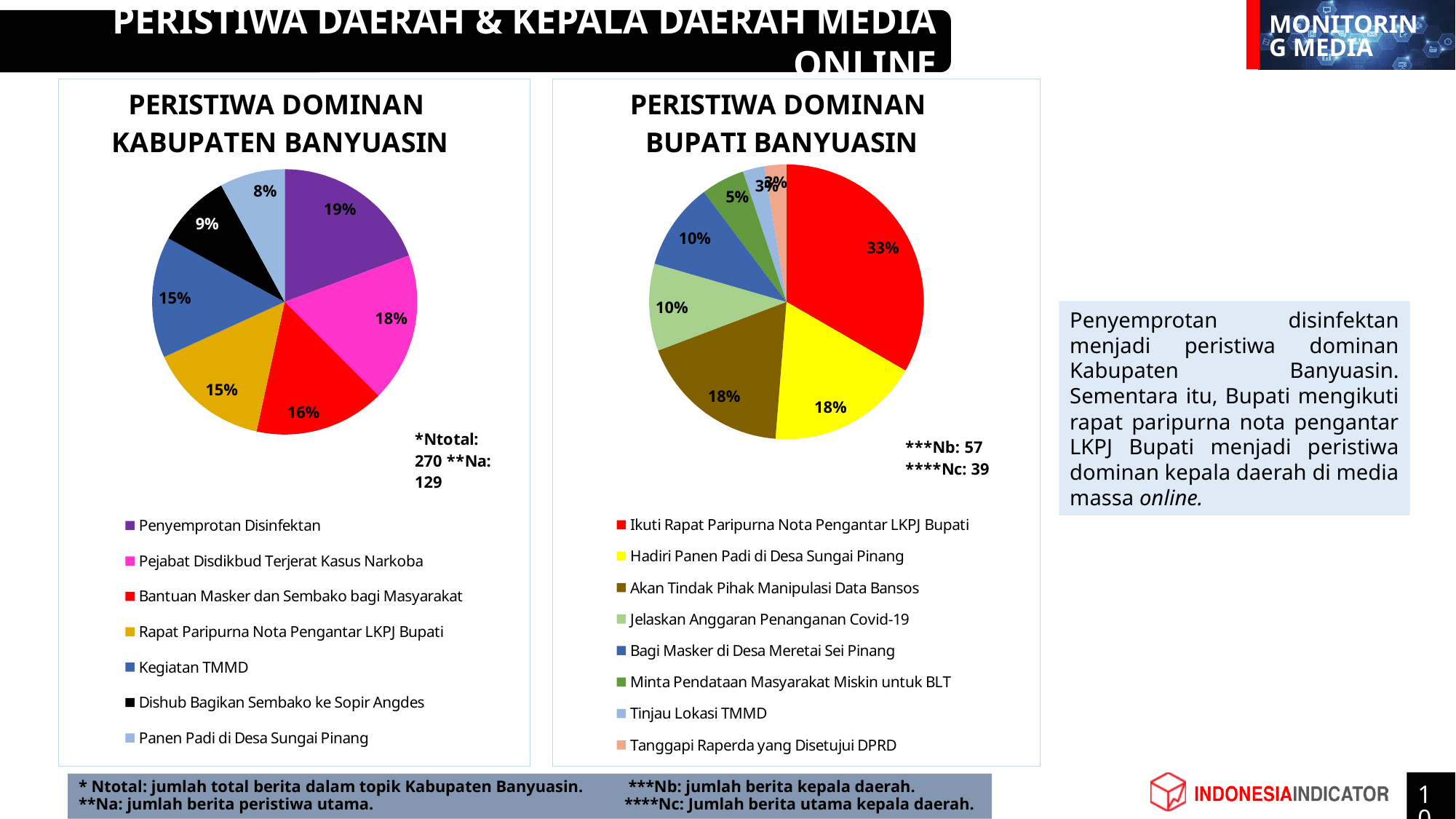
On the PERISTIWA DOMINAN BUPATI BANYUASIN chart, what share does Minta Pendataan Masyarakat Miskin untuk BLT have? 5% What type of chart is the PERISTIWA DOMINAN BUPATI BANYUASIN chart? Pie chart On the PERISTIWA DOMINAN KABUPATEN BANYUASIN chart, which category has the largest share? Penyemprotan Disinfektan On the PERISTIWA DOMINAN BUPATI BANYUASIN chart, which is larger: Hadiri Panen Padi di Desa Sungai Pinang or Jelaskan Anggaran Penanganan Covid-19? Hadiri Panen Padi di Desa Sungai Pinang On the PERISTIWA DOMINAN KABUPATEN BANYUASIN chart, what share does Bantuan Masker dan Sembako bagi Masyarakat have? 16% On the PERISTIWA DOMINAN KABUPATEN BANYUASIN chart, what share does Penyemprotan Disinfektan have? 19% On the PERISTIWA DOMINAN BUPATI BANYUASIN chart, which category has the largest share? Ikuti Rapat Paripurna Nota Pengantar LKPJ Bupati On the PERISTIWA DOMINAN BUPATI BANYUASIN chart, how many categories does the legend list? 8 On the PERISTIWA DOMINAN BUPATI BANYUASIN chart, what share does Ikuti Rapat Paripurna Nota Pengantar LKPJ Bupati have? 33% On the PERISTIWA DOMINAN KABUPATEN BANYUASIN chart, how many categories does the legend list? 7 On the PERISTIWA DOMINAN KABUPATEN BANYUASIN chart, what is the difference between the shares of Pejabat Disdikbud Terjerat Kasus Narkoba and Dishub Bagikan Sembako ke Sopir Angdes? 9% On the PERISTIWA DOMINAN KABUPATEN BANYUASIN chart, which category has the smallest share? Panen Padi di Desa Sungai Pinang